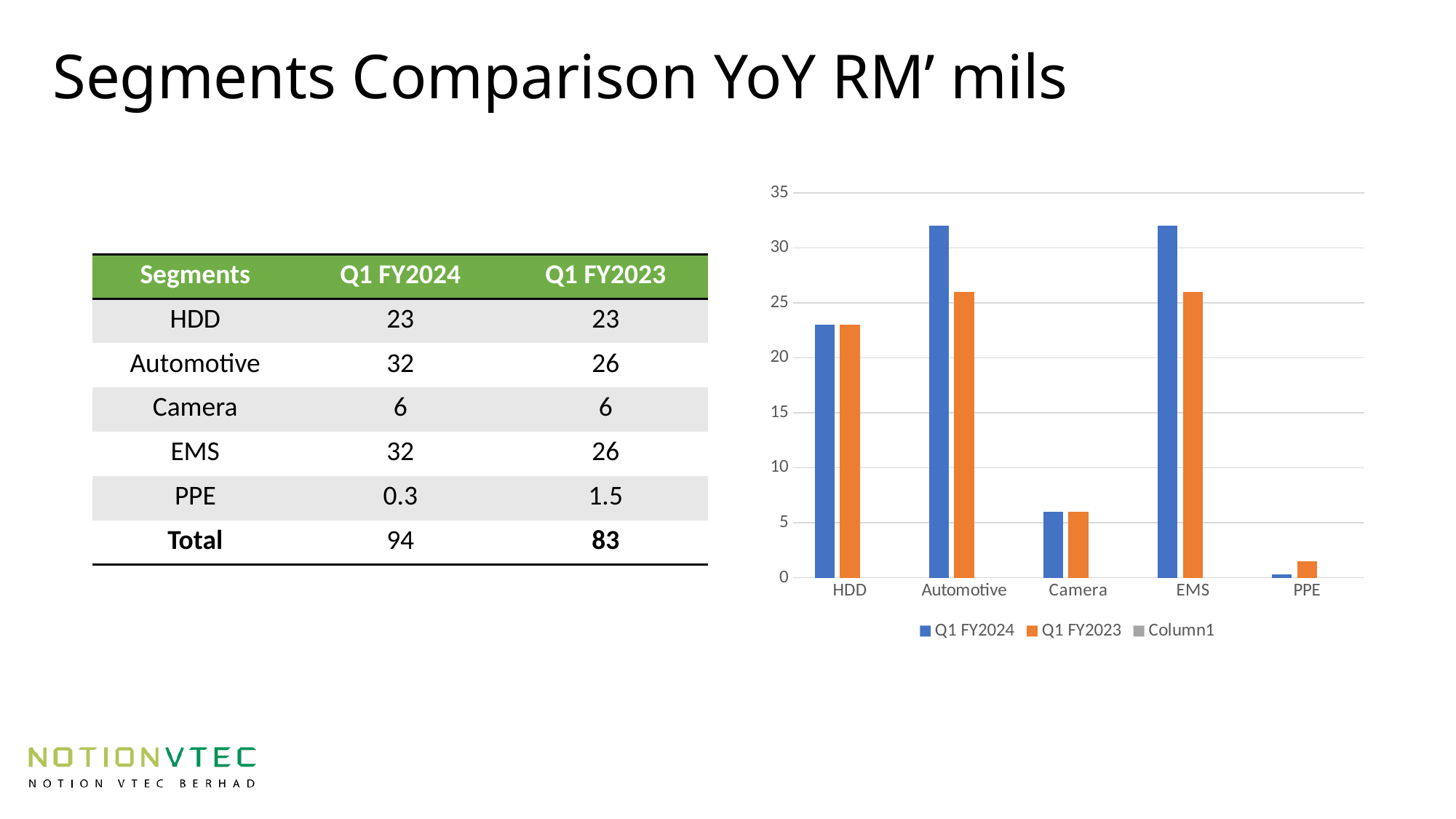
For PPE, which is larger: the Q1 FY2024 value or the Q1 FY2023 value? Q1 FY2023 Which series is shown in orange in the chart? Q1 FY2023 What is the difference between the Q1 FY2024 and Q1 FY2023 values for EMS? 6 How many series does the chart legend list? 3 For Automotive, which is larger: the Q1 FY2024 value or the Q1 FY2023 value? Q1 FY2024 What is the Q1 FY2023 value for EMS? 26 What kind of chart is shown on the slide? bar chart Which segment has the lowest Q1 FY2024 value? PPE Is the Q1 FY2024 value for Automotive greater or less than 30? greater What is the Q1 FY2023 value for PPE? 1.5 How many segments are shown on the x axis of the chart? 5 What is the Q1 FY2024 value for Automotive? 32